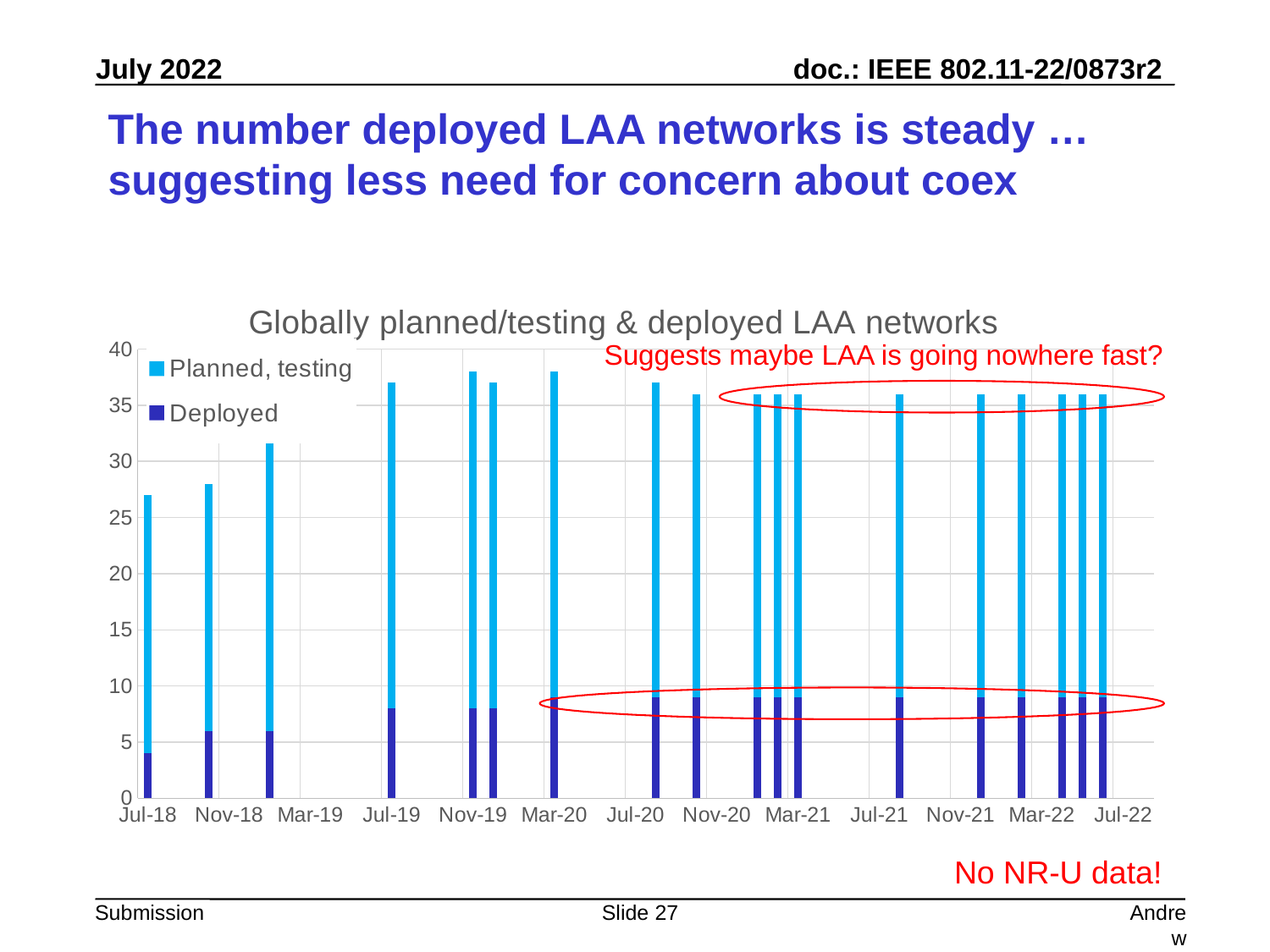
Is the total height of the bar at Mar-20 greater or less than 35? greater What kind of chart is shown on the slide? Stacked bar chart Is the Deployed value at Jul-18 greater or less than 5? less What is the title of the chart? Globally planned/testing & deployed LAA networks Is the total height of the bar at Jul-19 greater or less than 35? greater How many series does the chart legend list? 2 Does the Deployed value generally rise or fall from Jul-18 to Jul-22? rise Which bar has the lowest total height, Jul-18 or Jul-19? Jul-18 Which date has the lowest total bar in the chart? Jul-18 Which two series are listed in the chart legend? Planned, testing; Deployed